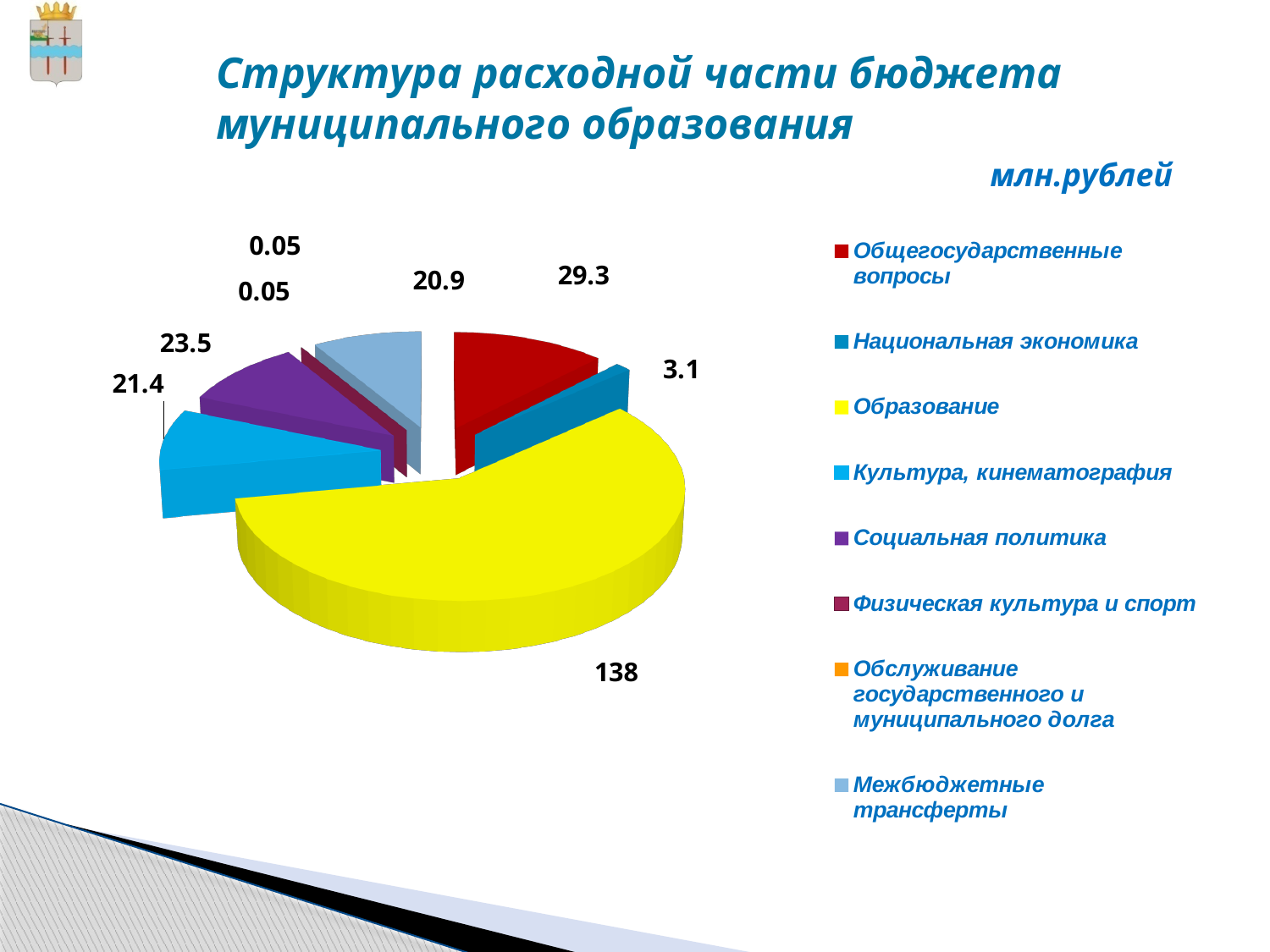
How many categories does the legend list? 8 Which category has the largest slice of the pie? Образование What is the value for Межбюджетные трансферты? 20.9 What is the difference between the values for Социальная политика and Культура, кинематография? 2.1 What is the value for Национальная экономика? 3.1 What is the value for Общегосударственные вопросы? 29.3 What is the difference between the values for Образование and Общегосударственные вопросы? 108.7 What unit is stated for the values on the slide? млн.рублей Which is larger, the value for Социальная политика or the value for Культура, кинематография? Социальная политика What type of chart is shown on the slide? pie chart What is the value for Культура, кинематография? 21.4 What is the value for Образование? 138